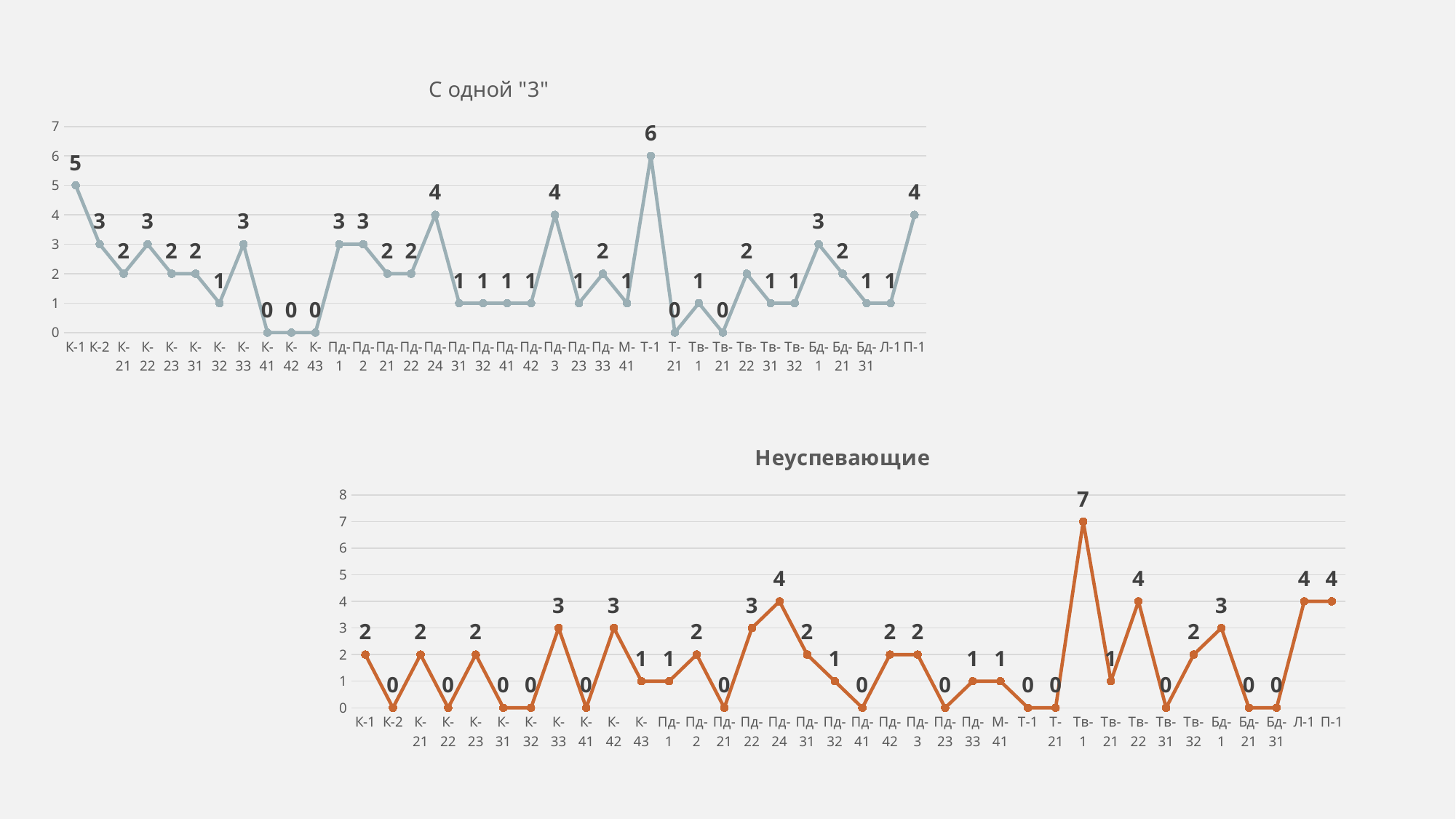
In the chart titled "Неуспевающие", what is the difference between the values for Тв-1 and Тв-22? 3 In the chart titled "Неуспевающие", what is the value for Бд-1? 3 In the chart titled "С одной "3"", which category has the highest value? Т-1 What kind of chart is the chart titled "Неуспевающие"? Line chart What is the title of the bottom chart on the slide? Неуспевающие In the chart titled "С одной "3"", what is the difference between the values for Т-1 and К-1? 1 In the chart titled "Неуспевающие", which category has the highest value? Тв-1 In the chart titled "С одной "3"", which is larger, the value for К-1 or the value for П-1? К-1 In the chart titled "С одной "3"", what is the value for К-1? 5 In the chart titled "Неуспевающие", what is the value for Тв-22? 4 In the chart titled "С одной "3"", what is the value for Т-1? 6 In the chart titled "Неуспевающие", what is the value for Пд-24? 4